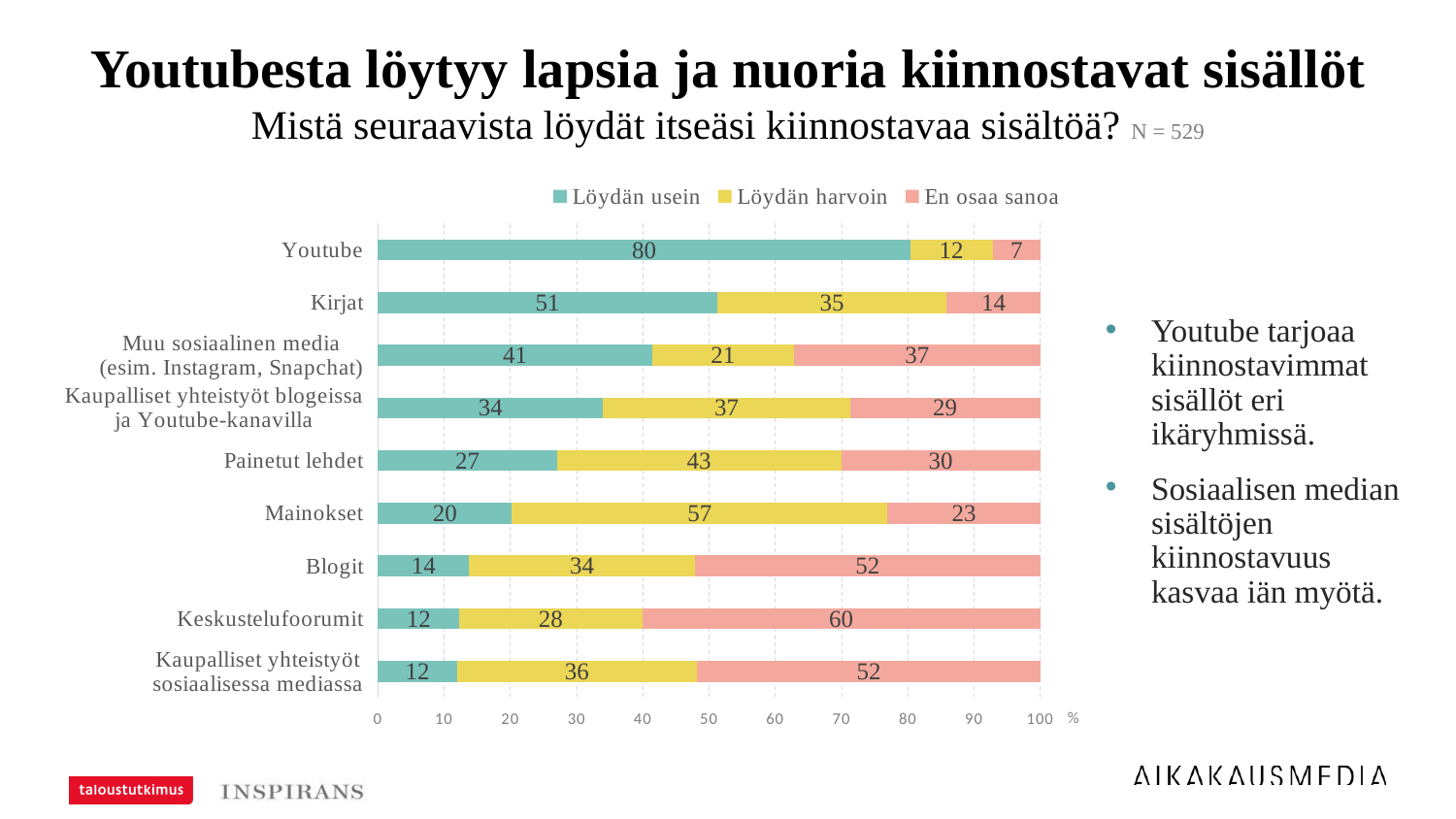
How many categories are shown on the chart? 9 What is the "En osaa sanoa" value for Keskustelufoorumit? 60 Which category has the lowest "En osaa sanoa" value? Youtube How many series does the legend list? 3 Which is larger: the "Löydän harvoin" value for Painetut lehdet or for Blogit? Painetut lehdet What percentage of respondents answered "Löydän usein" for Youtube? 80 What kind of chart is shown on the slide? Stacked bar chart What is the difference between the "Löydän usein" values for Youtube and Kirjat? 29 What is the "Löydän harvoin" value for Mainokset? 57 Which category has the highest "Löydän usein" value? Youtube What is the total of the stacked bar for Youtube? 99 What is the sample size (N) shown on the slide? 529